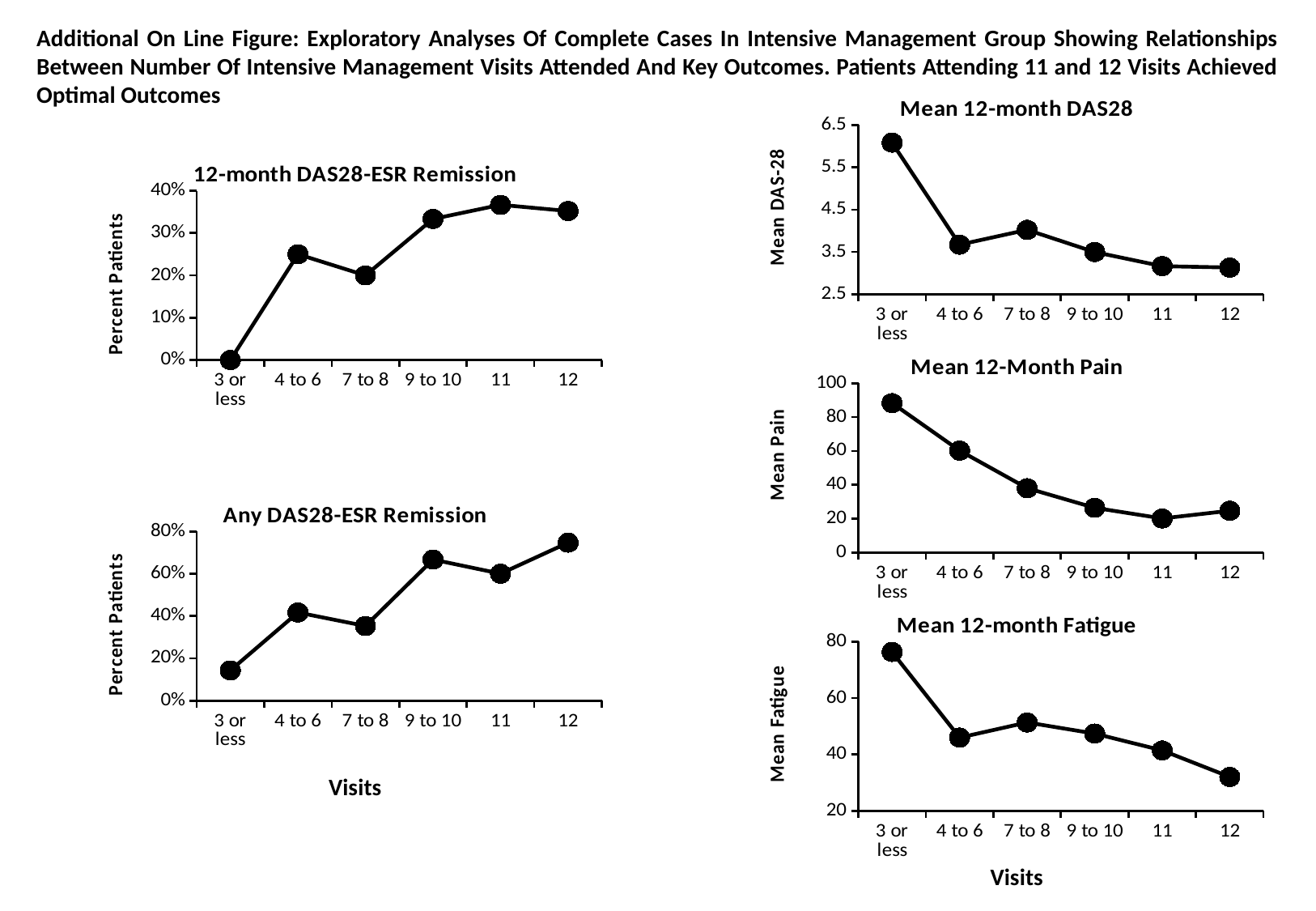
What is the y-axis label of the "Mean 12-Month Pain" chart? Mean Pain In the "12-month DAS28-ESR Remission" chart, how many visit categories are plotted on the x axis? 6 What kind of chart is the "12-month DAS28-ESR Remission" chart? line chart In the "Mean 12-Month Pain" chart, which is larger, the value for "4 to 6" visits or the value for "11" visits? 4 to 6 In the "Mean 12-month DAS28" chart, which visit category has the highest mean DAS-28? 3 or less In the "Any DAS28-ESR Remission" chart, which visit category has the highest value? 12 In the "Any DAS28-ESR Remission" chart, is the value for "9 to 10" visits greater or less than 60%? greater In the "12-month DAS28-ESR Remission" chart, is the value for "4 to 6" visits greater or less than 20%? greater In the "Mean 12-month Fatigue" chart, which visit category has the lowest mean fatigue? 12 In the "12-month DAS28-ESR Remission" chart, what is the value for "3 or less" visits? 0% In the "Any DAS28-ESR Remission" chart, which visit category has the lowest value? 3 or less